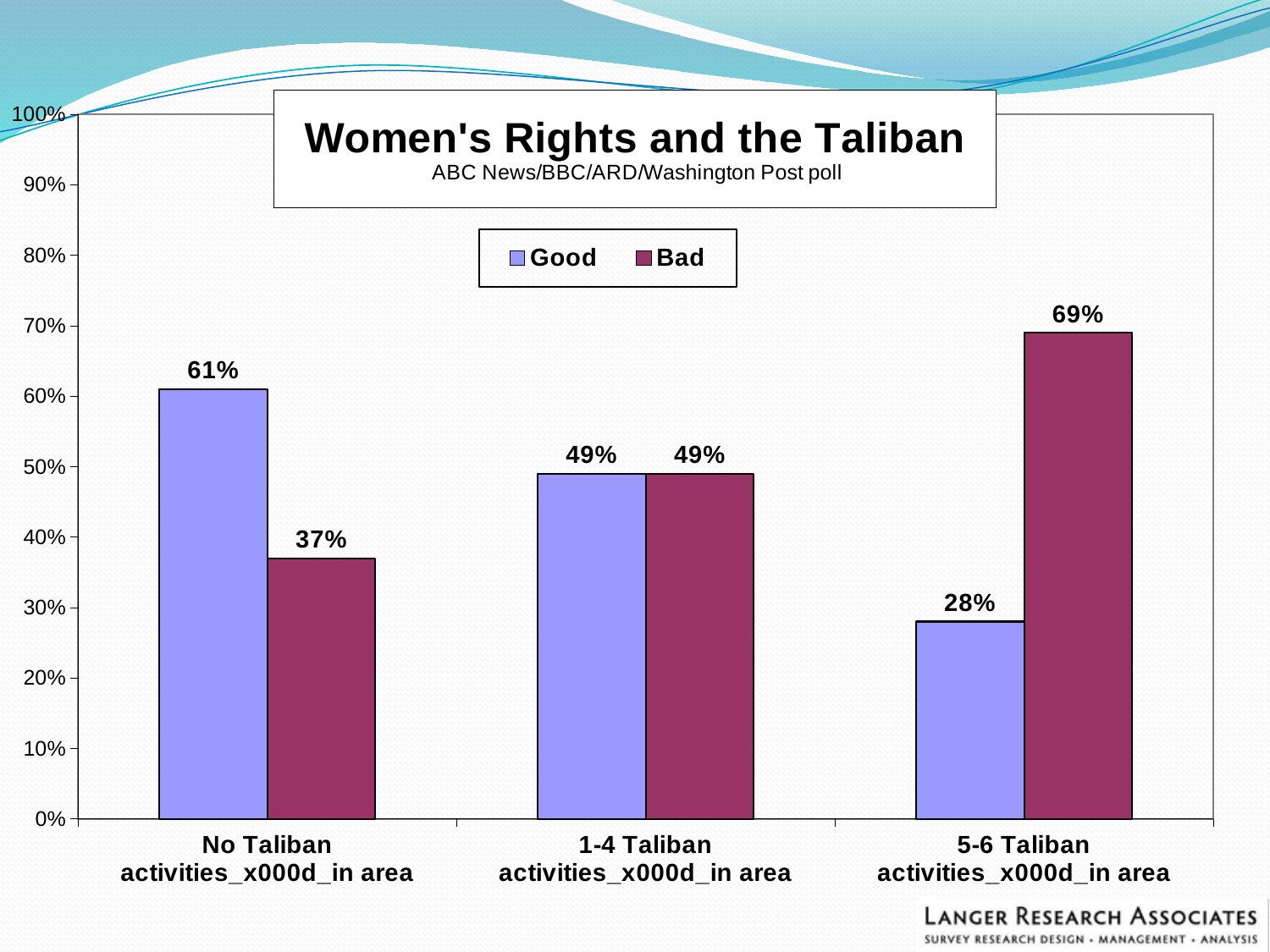
What is the difference between the Bad and Good values in the '5-6 Taliban activities in area' category? 41% Does the Good value rise or fall across the categories from left to right? Fall What kind of chart is shown on the slide? Bar chart How many categories are shown on the x axis? 3 Which category has the highest Bad value? 5-6 Taliban activities in area In the 'No Taliban activities in area' category, which is larger, Good or Bad? Good What is the value for Bad in the '5-6 Taliban activities in area' category? 69% How many series does the legend list? 2 What is the value for Good in the '1-4 Taliban activities in area' category? 49% Which category has the lowest Good value? 5-6 Taliban activities in area What is the value for Good in the 'No Taliban activities in area' category? 61% What is the value for Bad in the 'No Taliban activities in area' category? 37%